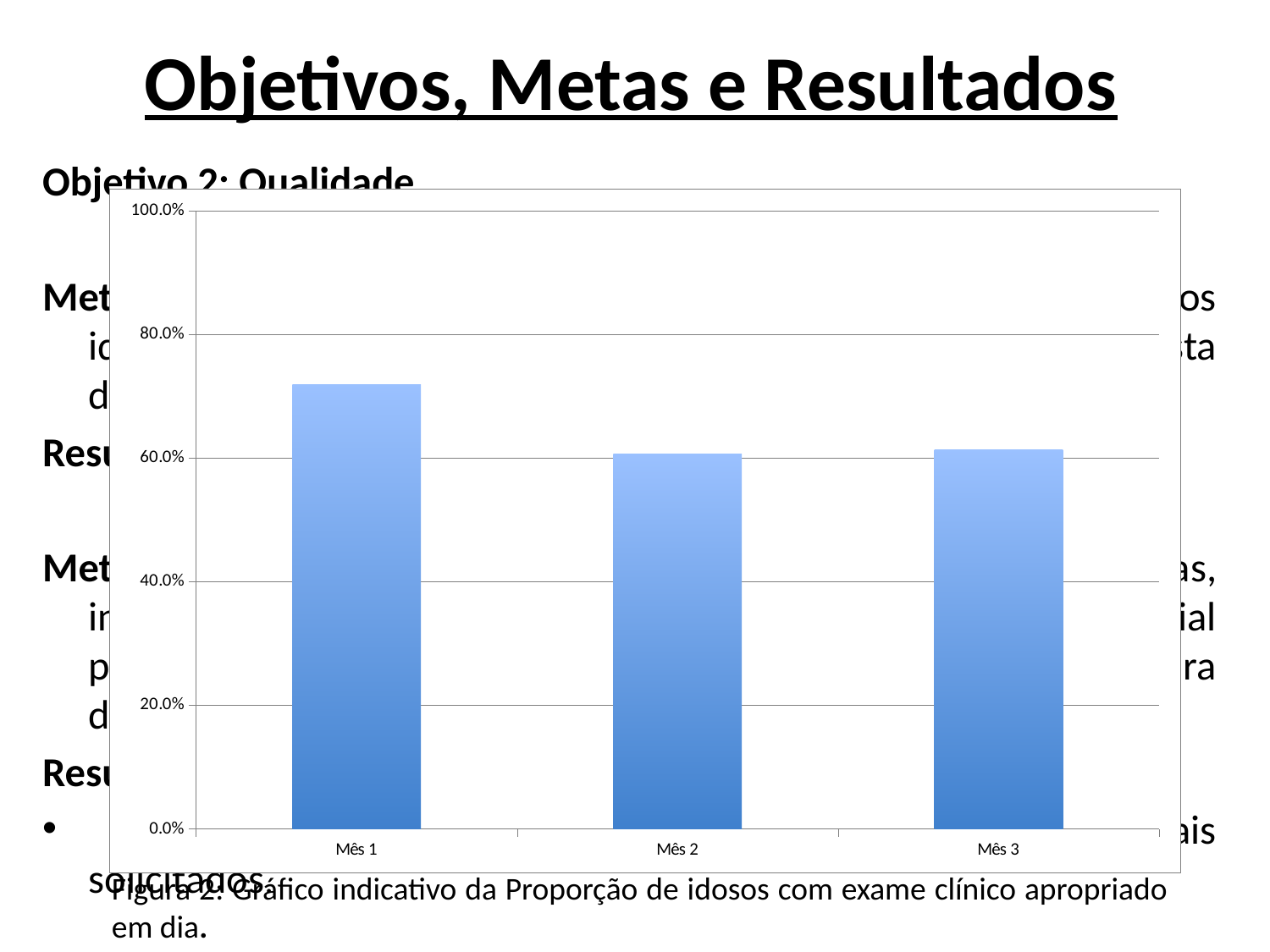
Is the value for Mês 3 greater or less than 80.0%? less Is the value for Mês 2 greater or less than 40.0%? greater According to the caption, what does Figura 2 indicate? Proporção de idosos com exame clínico apropriado em dia Which is larger, the value for Mês 1 or the value for Mês 3? Mês 1 Which is larger, the value for Mês 1 or the value for Mês 2? Mês 1 Which month has the highest value on the chart? Mês 1 What is the highest tick value shown on the vertical axis of the chart? 100.0% Is the value for Mês 1 greater or less than 60.0%? greater How many categories (months) are plotted on the chart? 3 What kind of chart is shown on the slide? bar chart Does the value rise or fall from Mês 1 to Mês 2? fall